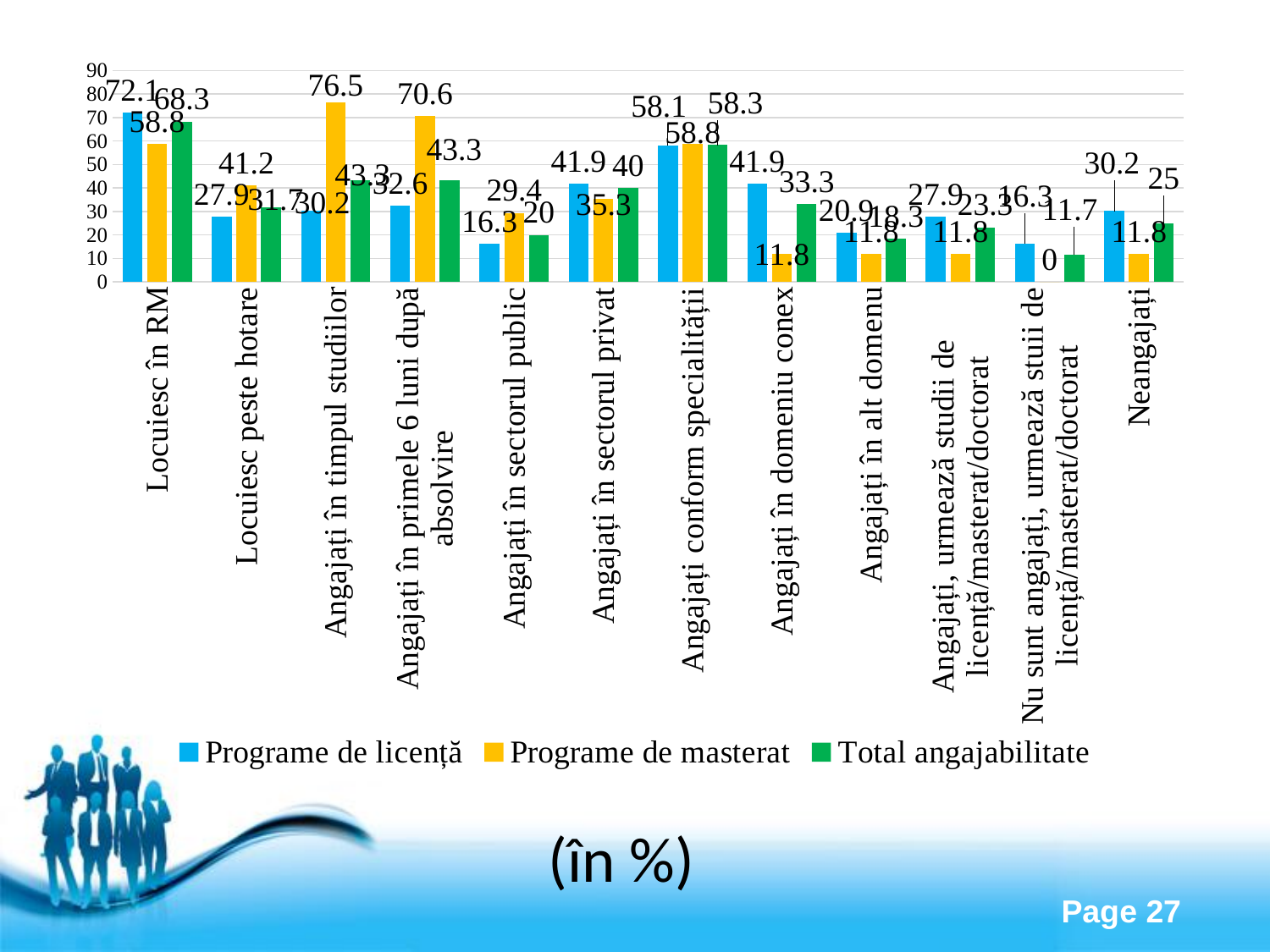
How many categories are shown on the x axis? 12 What is the difference between the Programe de masterat and Programe de licență values in the Angajați în primele 6 luni după absolvire category? 38 What is the value for Programe de masterat in the Nu sunt angajați, urmează stuii de licență/masterat/doctorat category? 0 How many series does the legend list? 3 Which category has the highest value for Programe de masterat? Angajați în timpul studiilor Is the Total angajabilitate value for Locuiesc în RM greater or less than 60? greater What is the value for Total angajabilitate in the Neangajați category? 25 What kind of chart is shown on the slide? bar chart In the Angajați în sectorul privat category, which is larger: Programe de licență or Programe de masterat? Programe de licență What is the value for Programe de licență in the Locuiesc în RM category? 72.1 Which category has the lowest value for Total angajabilitate? Nu sunt angajați, urmează stuii de licență/masterat/doctorat What is the value for Programe de masterat in the Angajați în timpul studiilor category? 76.5